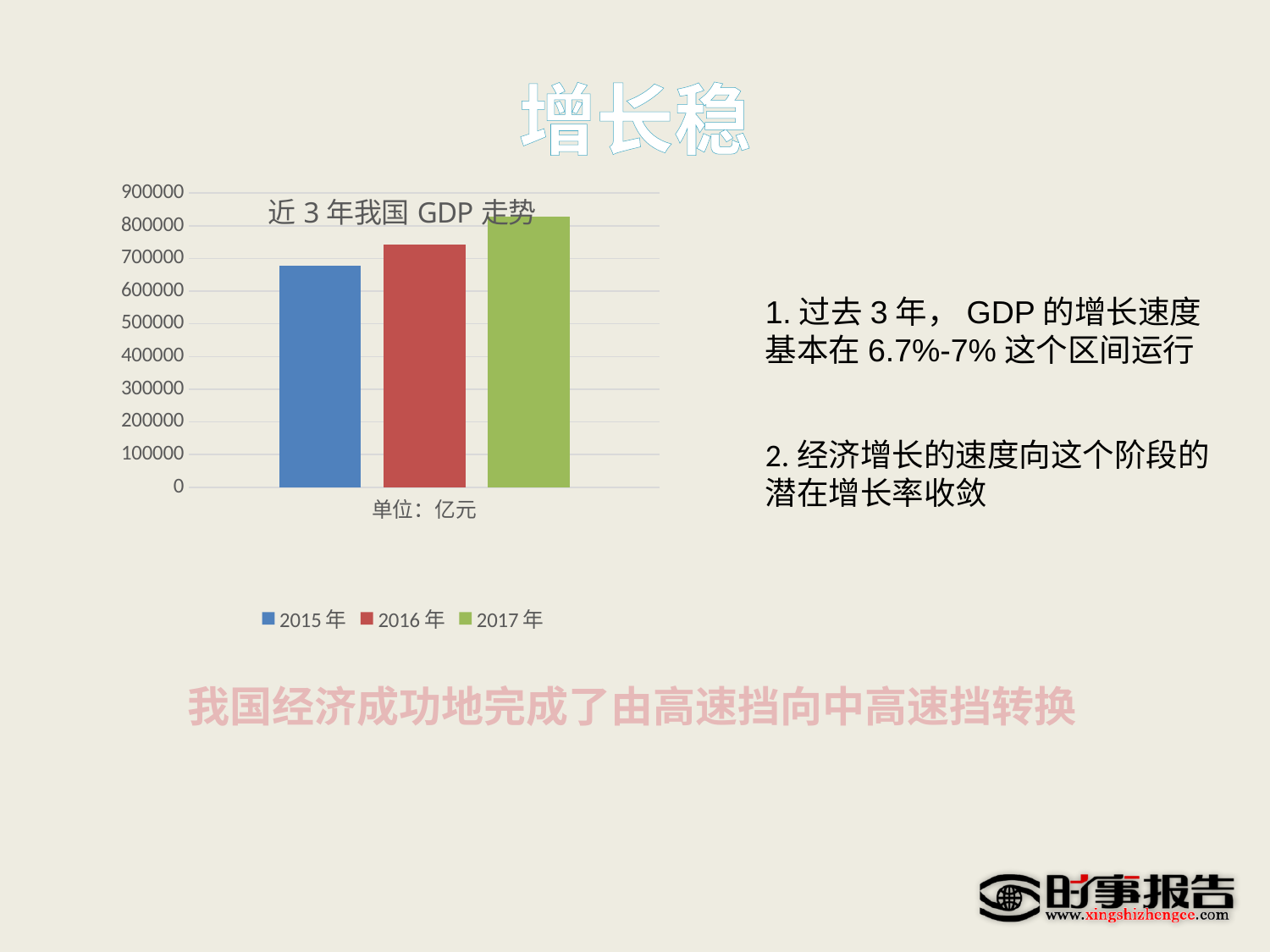
Is the value for 2017年 greater or less than 800000? greater Is the value for 2016年 greater or less than 700000? greater Is the value for 2015年 greater or less than 700000? less What kind of chart is shown on the slide? bar chart What unit is stated below the chart's bars? 亿元 What is the title of the chart? 近3年我国GDP走势 Do the values rise or fall from 2015年 to 2017年? rise How many bars are plotted in the chart? 3 Which year has the highest GDP value in the chart? 2017年 How many series does the legend list? 3 Which year has the lowest GDP value in the chart? 2015年 Which is larger, the value for 2016年 or the value for 2015年? 2016年